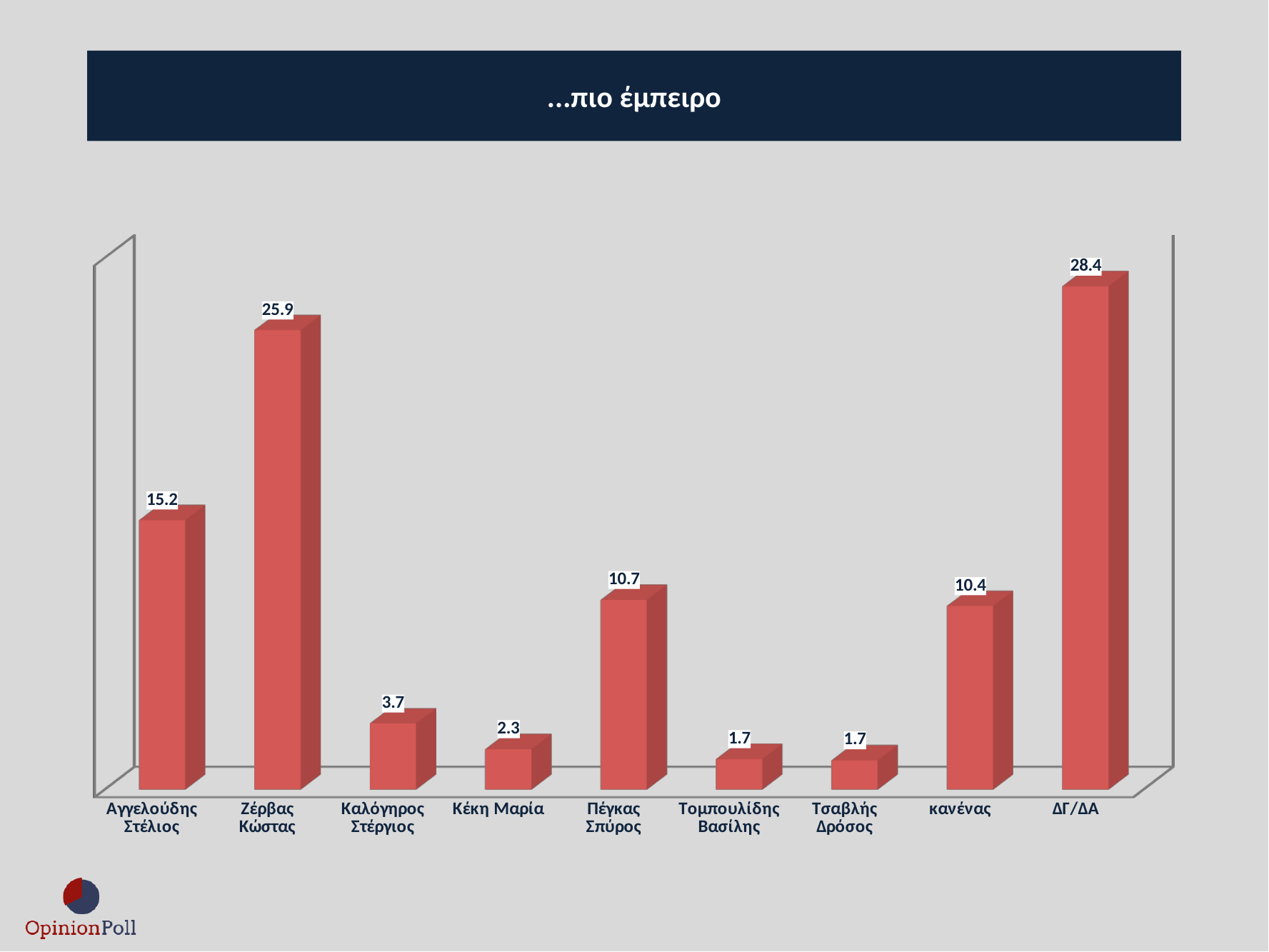
What is the value for Ζέρβας Κώστας? 25.9 What is the title of the chart? ...πιο έμπειρο What is the value for Πέγκας Σπύρος? 10.7 What kind of chart is shown on the slide? bar chart How many categories are shown on the x axis? 9 Which candidate has the highest value among the named candidates? Ζέρβας Κώστας Which is larger, the value for Καλόγηρος Στέργιος or the value for Κέκη Μαρία? Καλόγηρος Στέργιος Which category has the highest value? ΔΓ/ΔΑ What is the value for κανένας? 10.4 What is the value for Αγγελούδης Στέλιος? 15.2 What is the difference between the values for ΔΓ/ΔΑ and Ζέρβας Κώστας? 2.5 What is the difference between the values for Αγγελούδης Στέλιος and Πέγκας Σπύρος? 4.5